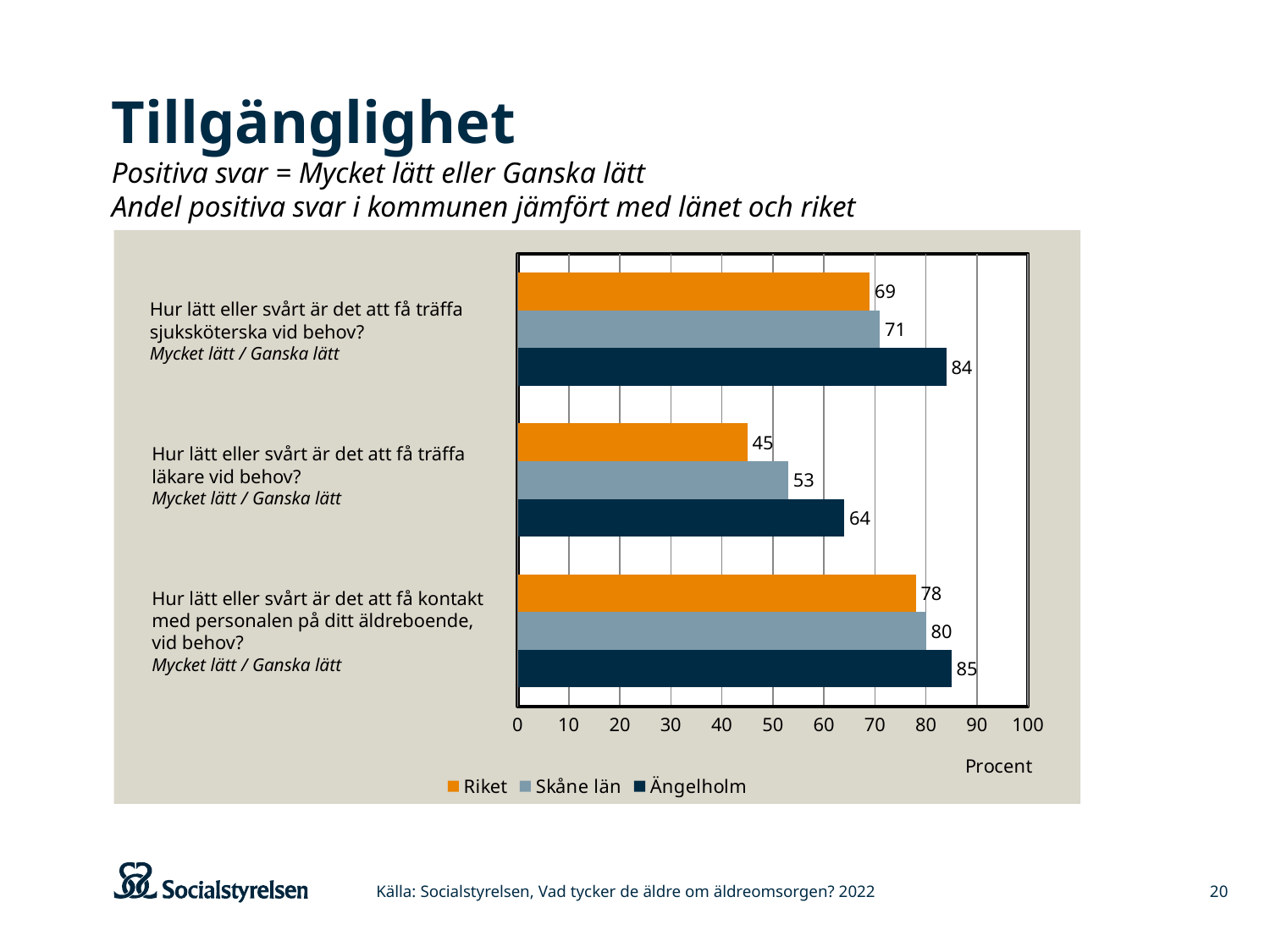
What is the value for Riket on the question about meeting a doctor when needed (träffa läkare vid behov)? 45 What kind of chart is shown on the slide? Bar chart How many series does the legend list? 3 What is the value for Skåne län on the question about getting in contact with staff at the care home (kontakt med personalen på ditt äldreboende)? 80 What is the difference between Skåne län and Riket on the question about meeting a doctor when needed? 8 Which series has the highest value on the question about meeting a doctor when needed? Ängelholm What is the difference between Ängelholm and Riket on the question about meeting a nurse when needed? 15 Which is larger on the question about contact with staff at the care home: Riket or Skåne län? Skåne län What unit is shown on the x axis of the chart? Procent What is the value for Ängelholm on the question about meeting a nurse when needed (träffa sjuksköterska vid behov)? 84 How many questions (categories) are shown in the chart? 3 Which question has the lowest value for Ängelholm? Hur lätt eller svårt är det att få träffa läkare vid behov?